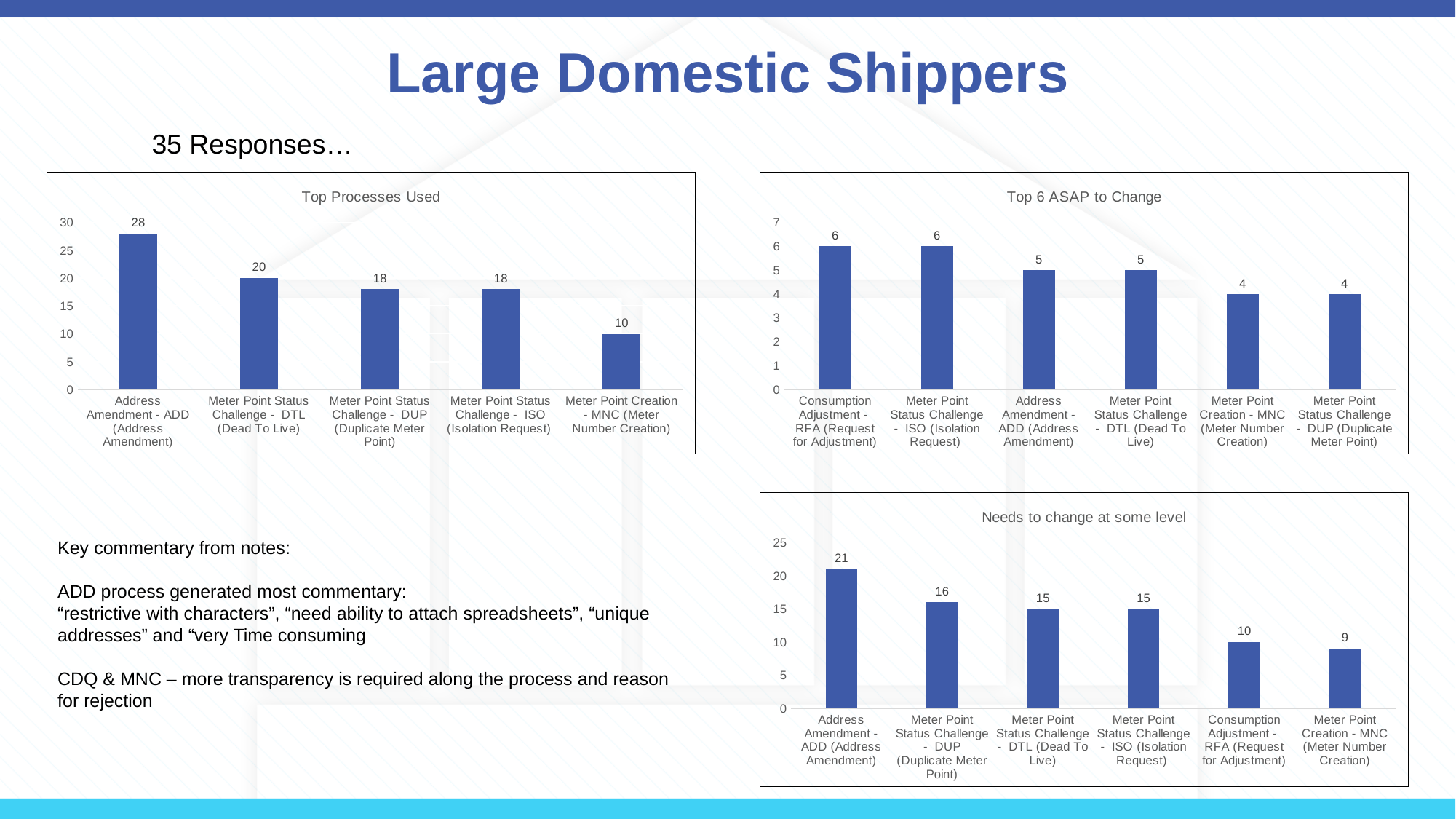
In the 'Top 6 ASAP to Change' chart, is the value for Address Amendment - ADD larger or smaller than the value for Meter Point Status Challenge - DUP? larger In the 'Top Processes Used' chart, what is the difference between the values for Address Amendment - ADD and Meter Point Status Challenge - DTL (Dead To Live)? 8 How many categories are shown in the 'Top Processes Used' chart? 5 What type of chart is the 'Needs to change at some level' chart? Bar chart How many categories are shown in the 'Top 6 ASAP to Change' chart? 6 In the 'Needs to change at some level' chart, which category has the highest value? Address Amendment - ADD (Address Amendment) In the 'Top 6 ASAP to Change' chart, what is the value for Meter Point Creation - MNC (Meter Number Creation)? 4 In the 'Top Processes Used' chart, what is the value for Address Amendment - ADD (Address Amendment)? 28 In the 'Top 6 ASAP to Change' chart, what is the value for Consumption Adjustment - RFA (Request for Adjustment)? 6 In the 'Needs to change at some level' chart, what is the value for Meter Point Status Challenge - DUP (Duplicate Meter Point)? 16 In the 'Top Processes Used' chart, which category has the lowest value? Meter Point Creation - MNC (Meter Number Creation) In the 'Needs to change at some level' chart, what is the difference between the values for Consumption Adjustment - RFA and Meter Point Creation - MNC? 1